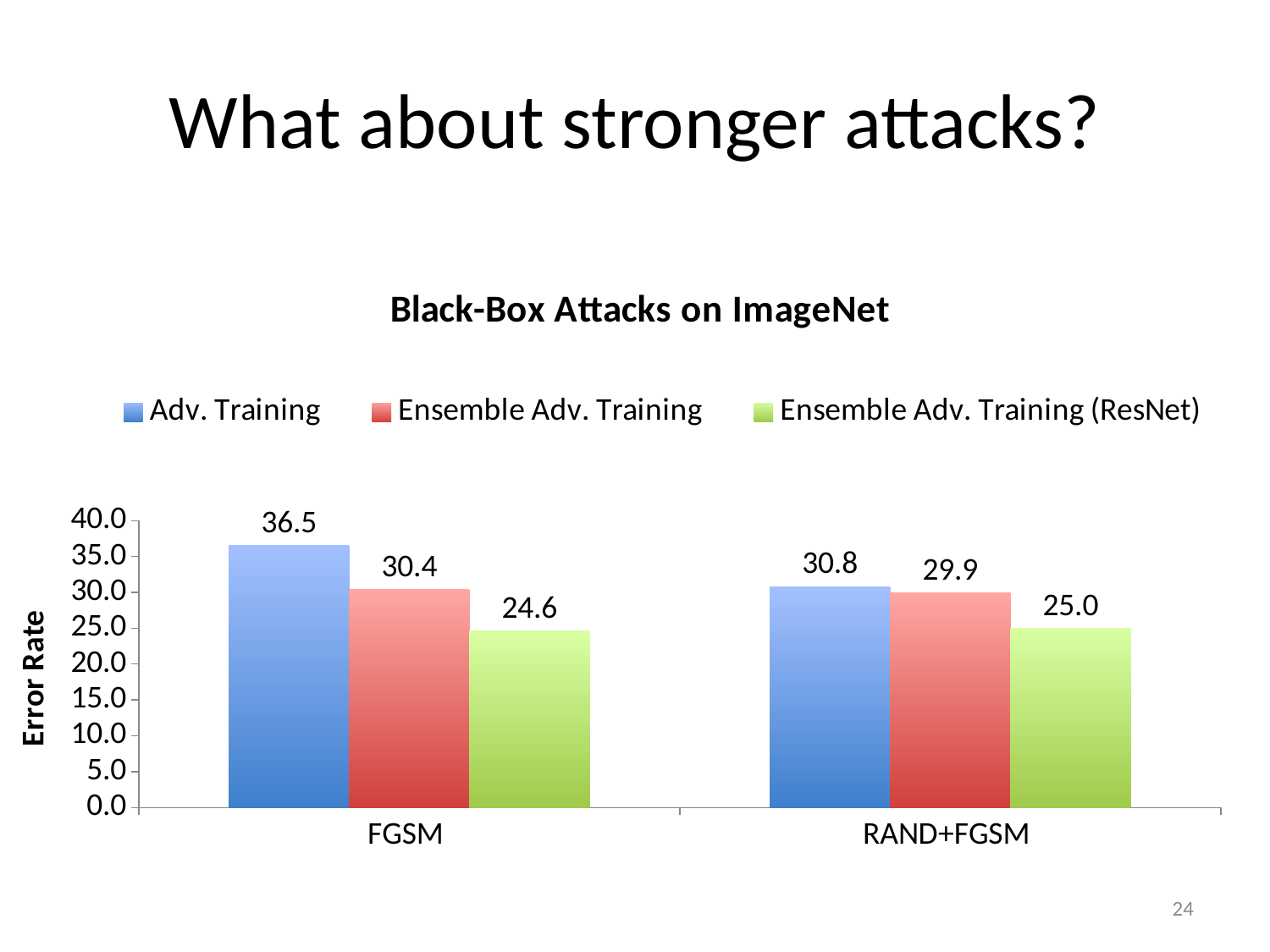
What is the error rate for Ensemble Adv. Training under the RAND+FGSM attack? 29.9 How many series does the legend list? 3 What kind of chart is shown on the slide? bar chart Which series has the lowest error rate under the RAND+FGSM attack? Ensemble Adv. Training (ResNet) Which is larger: the Adv. Training error rate under FGSM or under RAND+FGSM? FGSM How many attack categories are shown on the x axis? 2 Is the error rate for Ensemble Adv. Training (ResNet) under FGSM greater or less than 30.0? less What is the difference between the Adv. Training error rate and the Ensemble Adv. Training error rate under FGSM? 6.1 Which series has the highest error rate under the FGSM attack? Adv. Training What is the title of the chart? Black-Box Attacks on ImageNet What is the error rate for Adv. Training under the FGSM attack? 36.5 What is the error rate for Ensemble Adv. Training (ResNet) under the RAND+FGSM attack? 25.0